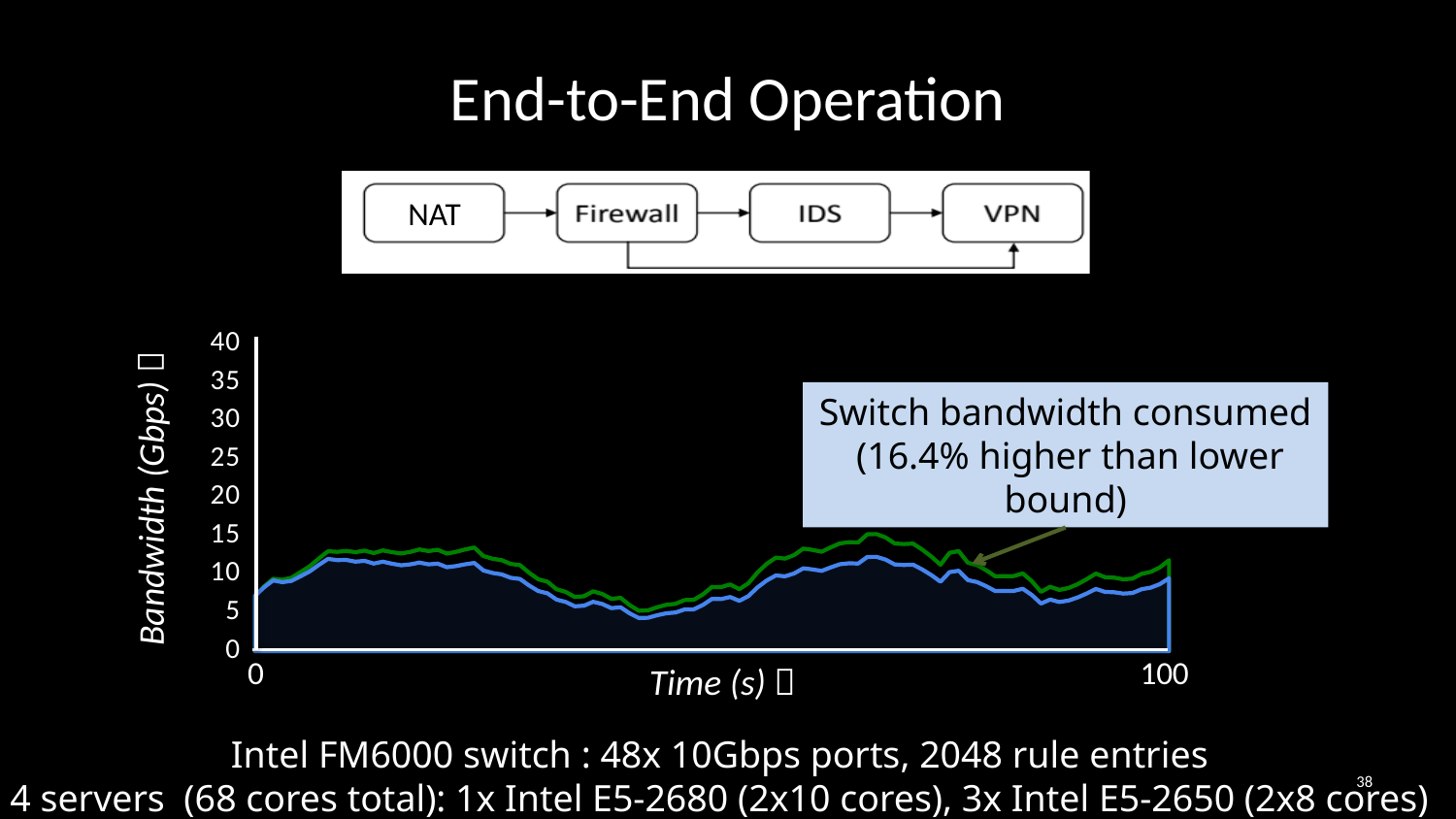
Between time 0 and about time 20, does the blue line rise or fall? rise How many lines are plotted on the chart? 2 According to the annotation, by what percentage is the switch bandwidth consumed higher than the lower bound? 16.4% Is the value of the blue line at time 100 greater or less than 5? greater Is the lowest value reached by the blue line greater or less than 10? less What is the label of the y axis? Bandwidth (Gbps) Which line is higher throughout the chart, the green line or the blue line? green Between about time 25 and about time 45, does the green line rise or fall? fall Is the value of the green line at time 0 greater or less than 10? less What kind of chart is shown on the slide? area chart